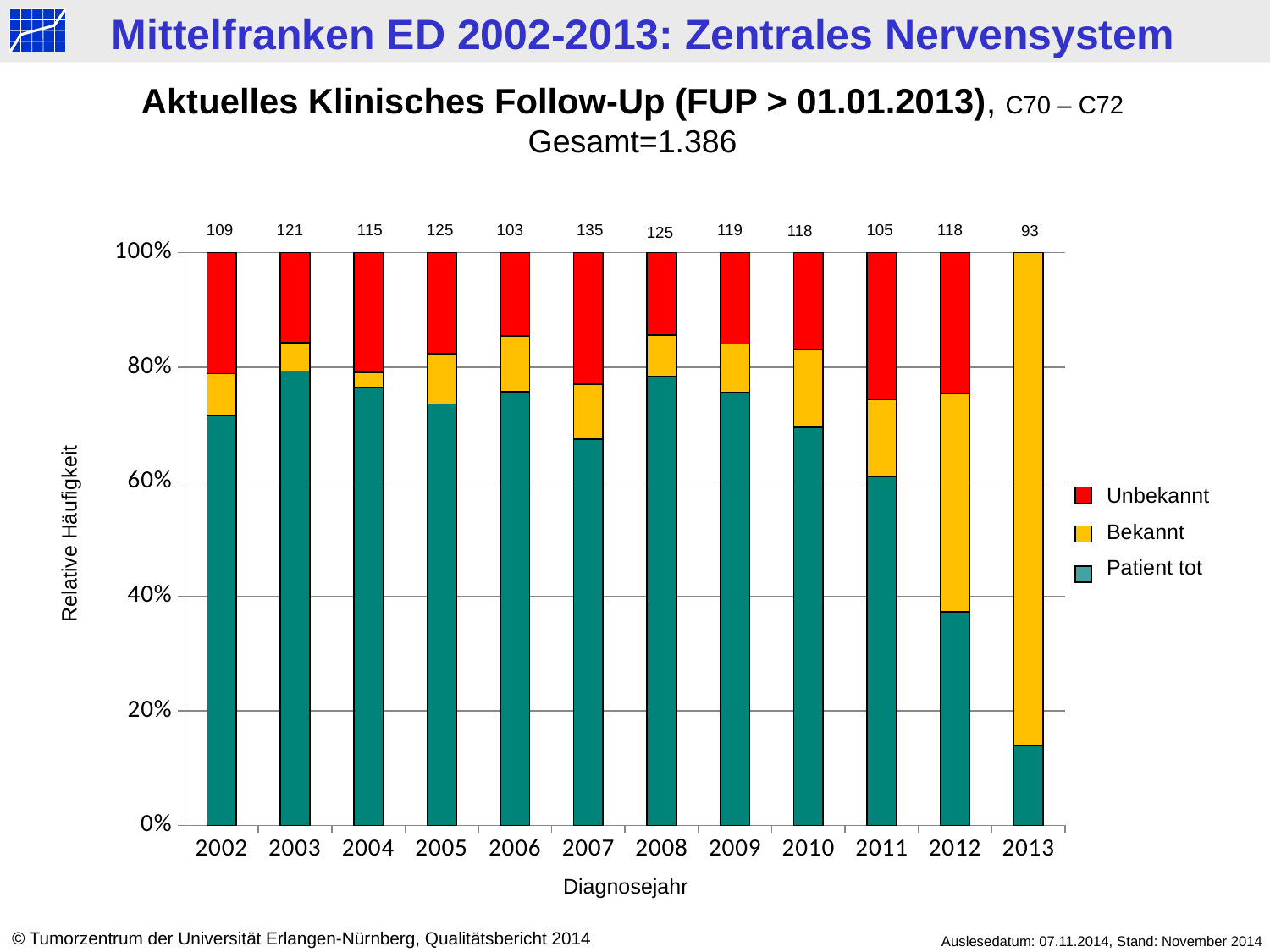
Is the 'Patient tot' share for 2013 greater or less than 20%? less What is the difference between the numbers printed above the bars for 2007 and 2013? 42 Which diagnosis year has the lowest number printed above its bar? 2013 Which year has the larger number printed above its bar, 2003 or 2004? 2003 What number is printed above the bar for 2002? 109 Which diagnosis year has the highest number printed above its bar? 2007 Is the 'Patient tot' share for 2012 greater or less than 40%? less How many series does the legend list? 3 What number is printed above the bar for 2007? 135 How many diagnosis years are shown on the x axis? 12 What number is printed above the bar for 2013? 93 What kind of chart is shown on the slide? Stacked bar chart